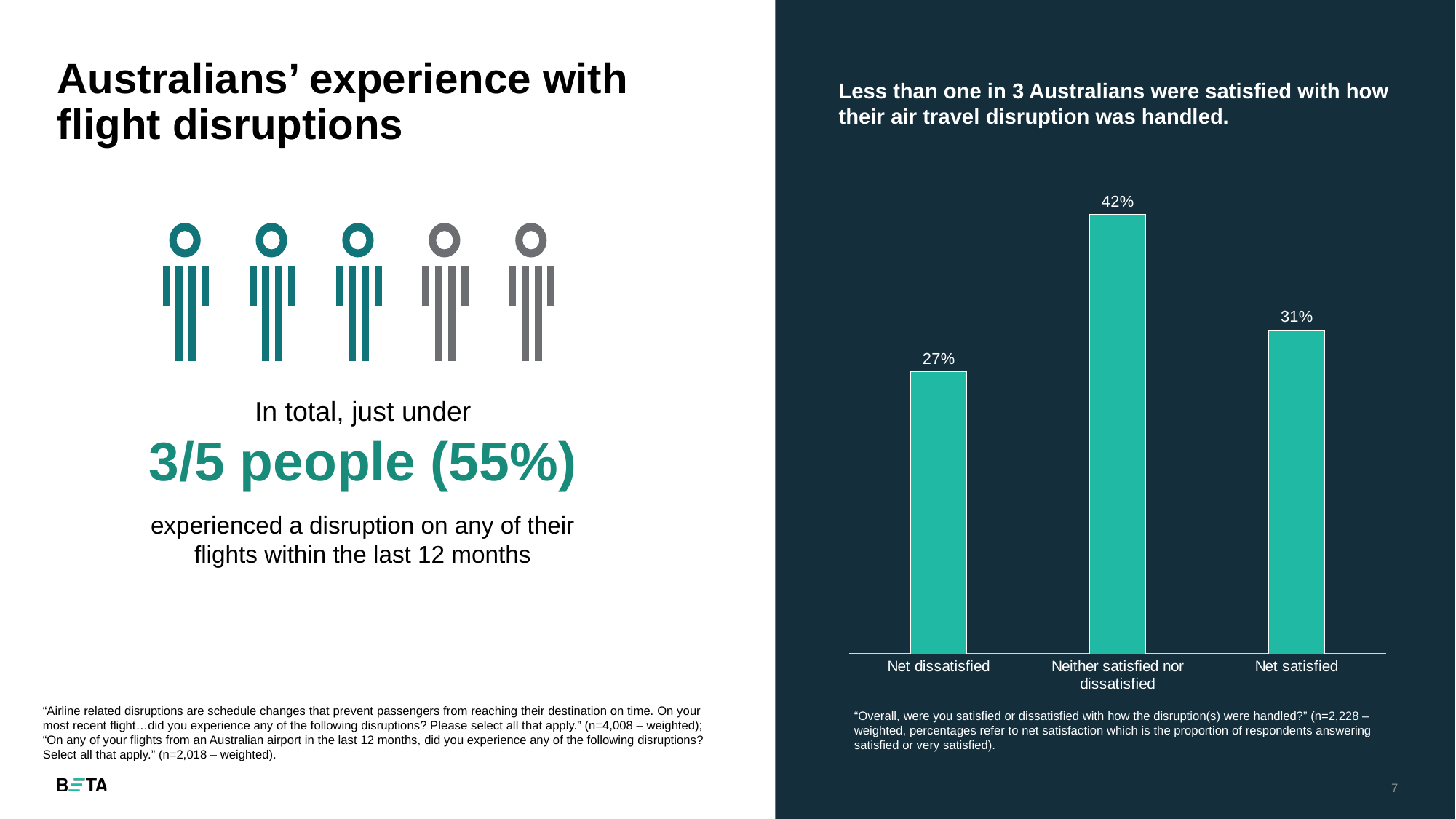
What percentage of respondents were net dissatisfied with how their disruption was handled? 27% How many categories are shown in the bar chart? 3 Which is larger, the value for 'Net satisfied' or 'Net dissatisfied'? Net satisfied What kind of chart is shown on the right side of the slide? Bar chart What colour are the bars in the chart? Teal Which category has the highest value in the bar chart? Neither satisfied nor dissatisfied What percentage of respondents were neither satisfied nor dissatisfied? 42% Which category has the lowest value in the bar chart? Net dissatisfied What is the difference between the 'Neither satisfied nor dissatisfied' and 'Net satisfied' values? 11% What percentage of respondents were net satisfied? 31% What is the difference between the 'Net satisfied' and 'Net dissatisfied' values? 4% What is the total of the three percentages shown in the bar chart? 100%